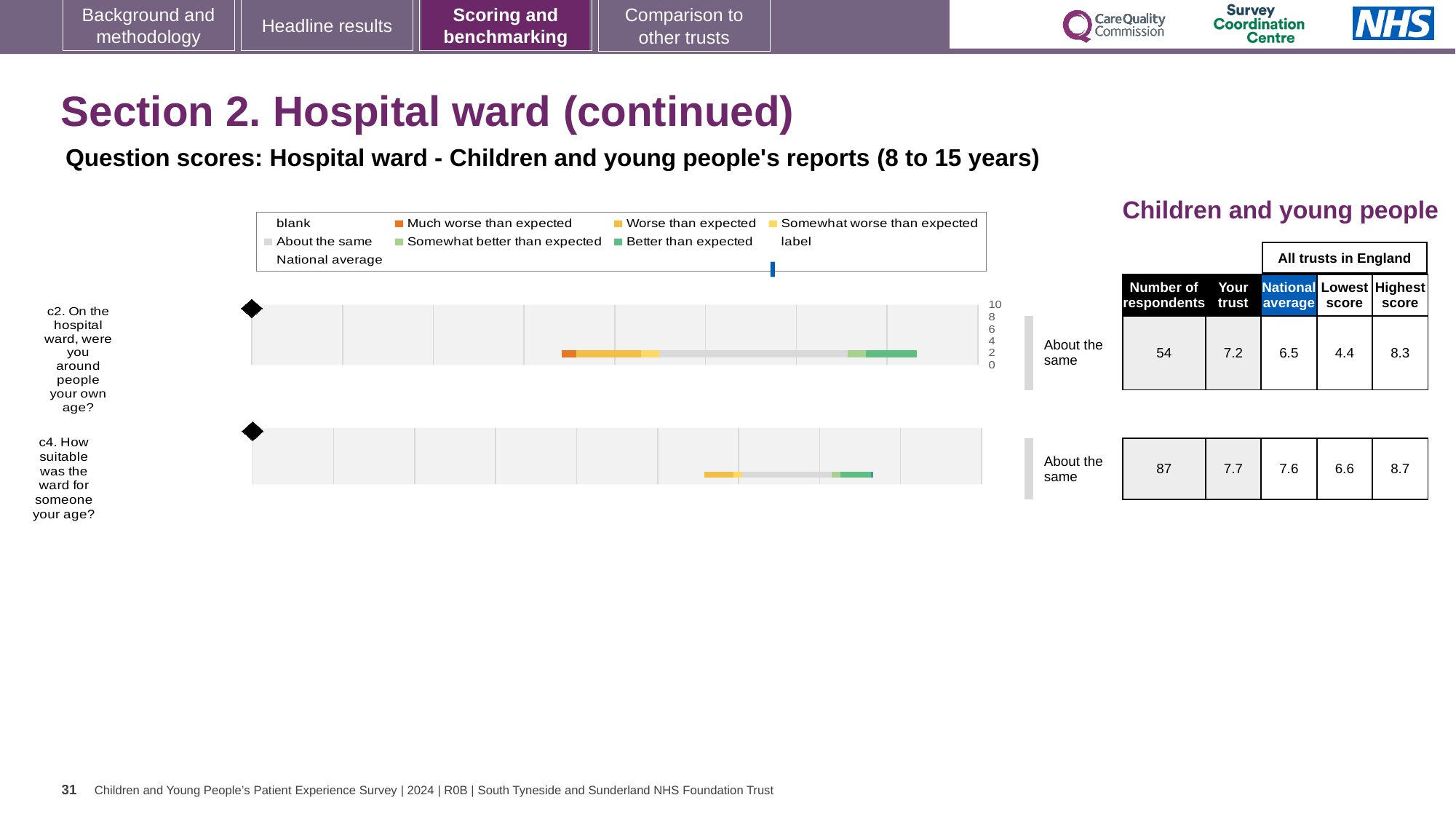
Which question has more respondents, c2 or c4? c4 What is the 'Your trust' score for question c4 (How suitable was the ward for someone your age?)? 7.7 How many respondents answered question c4? 87 What is the difference between the highest score and the lowest score for question c2? 3.9 What is the highest value shown on the score axis of the charts? 10 What is the national average score for question c2? 6.5 What kind of chart is used to show the question scores on this slide? bar chart What benchmark category is shown next to the bar for question c4? About the same What is the 'Your trust' score for question c2 (On the hospital ward, were you around people your own age?)? 7.2 How many questions (bars) are plotted on the slide? 2 What is the difference between the 'Your trust' score and the national average for question c2? 0.7 Which question has the higher 'Your trust' score, c2 or c4? c4